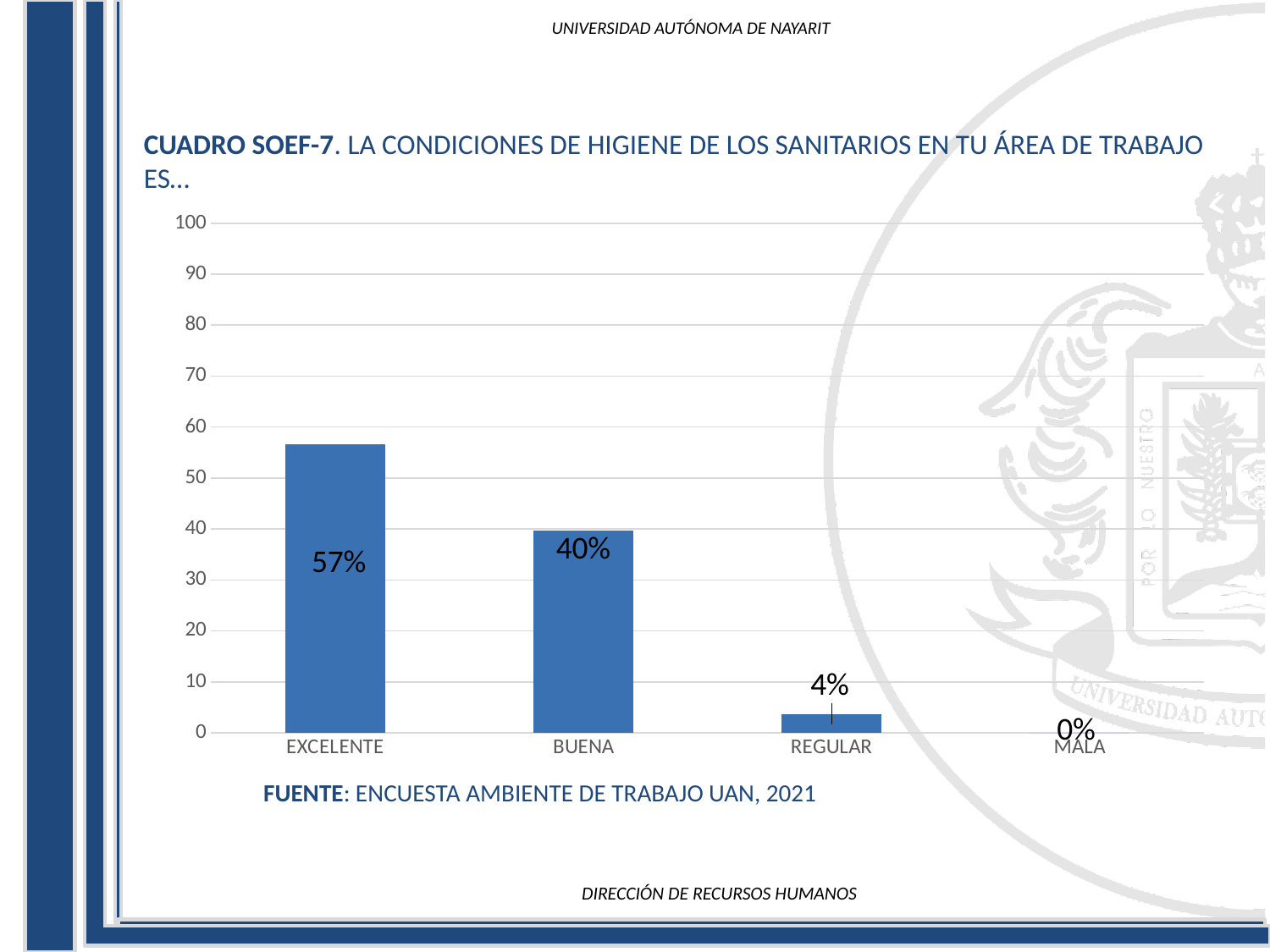
Which is larger, the value for BUENA or the value for REGULAR? BUENA What is the value for BUENA? 40% What is the difference between the values for EXCELENTE and BUENA? 17% What is the value for REGULAR? 4% What kind of chart is shown on the slide? bar chart How many categories are shown on the x axis? 4 Which category has the highest value? EXCELENTE Which category has the lowest value? MALA Do the values rise or fall from left to right along the x axis? fall What is the value for MALA? 0% What is the value for EXCELENTE? 57% Is the value for EXCELENTE greater or less than 50? greater